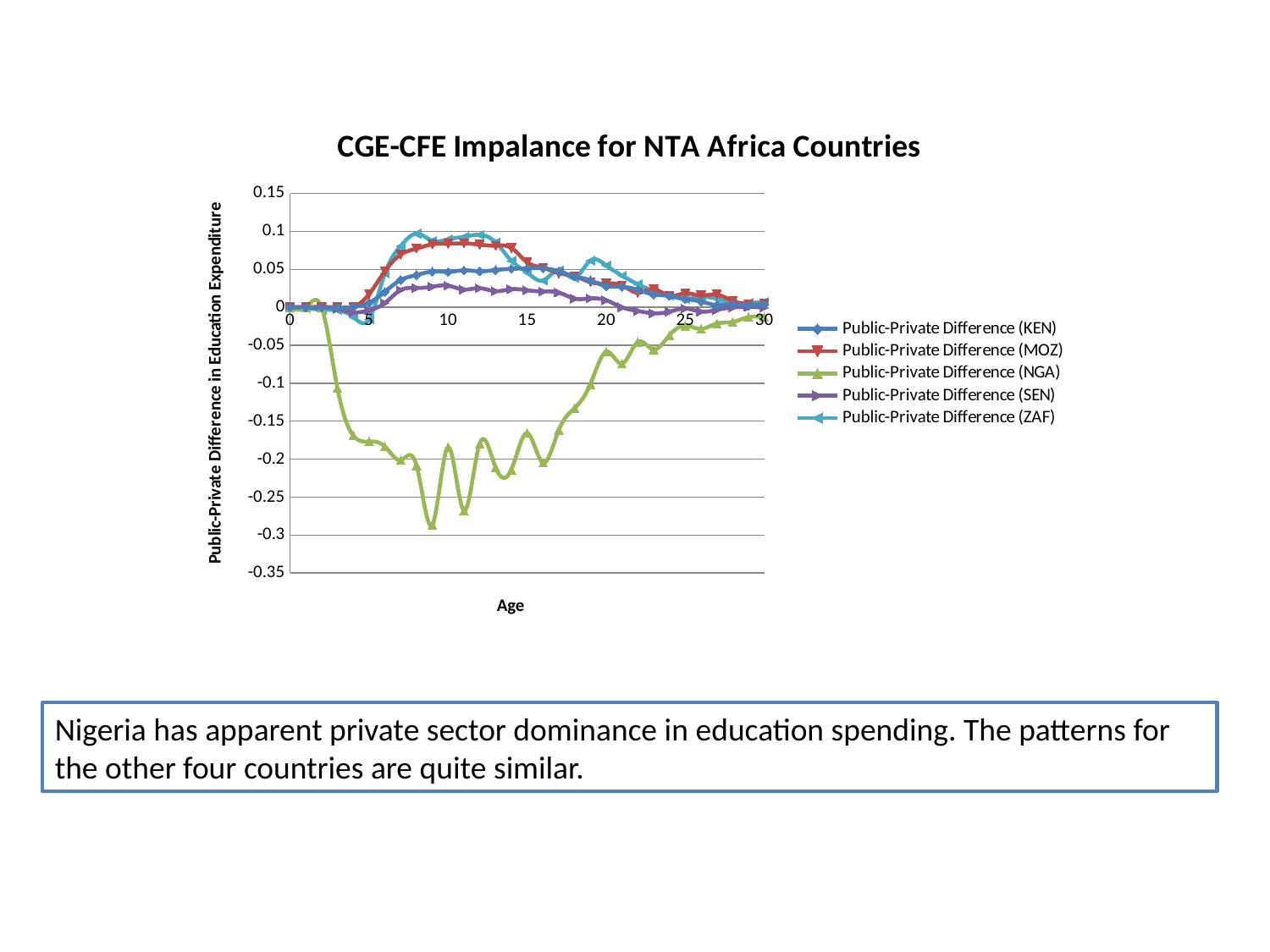
At age 10, which is larger: Public-Private Difference (KEN) or Public-Private Difference (MOZ)? Public-Private Difference (MOZ) Is the value for Public-Private Difference (MOZ) at age 10 greater or less than 0.05? greater Is the value for Public-Private Difference (SEN) at age 10 greater or less than 0.05? less Is the value for Public-Private Difference (NGA) at age 8 greater or less than -0.25? greater How many series does the legend list? 5 Does the Public-Private Difference (NGA) series generally rise or fall between age 10 and age 30? rise What is the title of the chart? CGE-CFE Impalance for NTA Africa Countries Which series has the lowest values across most of the age range? Public-Private Difference (NGA) What type of chart is shown on the slide? line chart What is the label of the x axis? Age